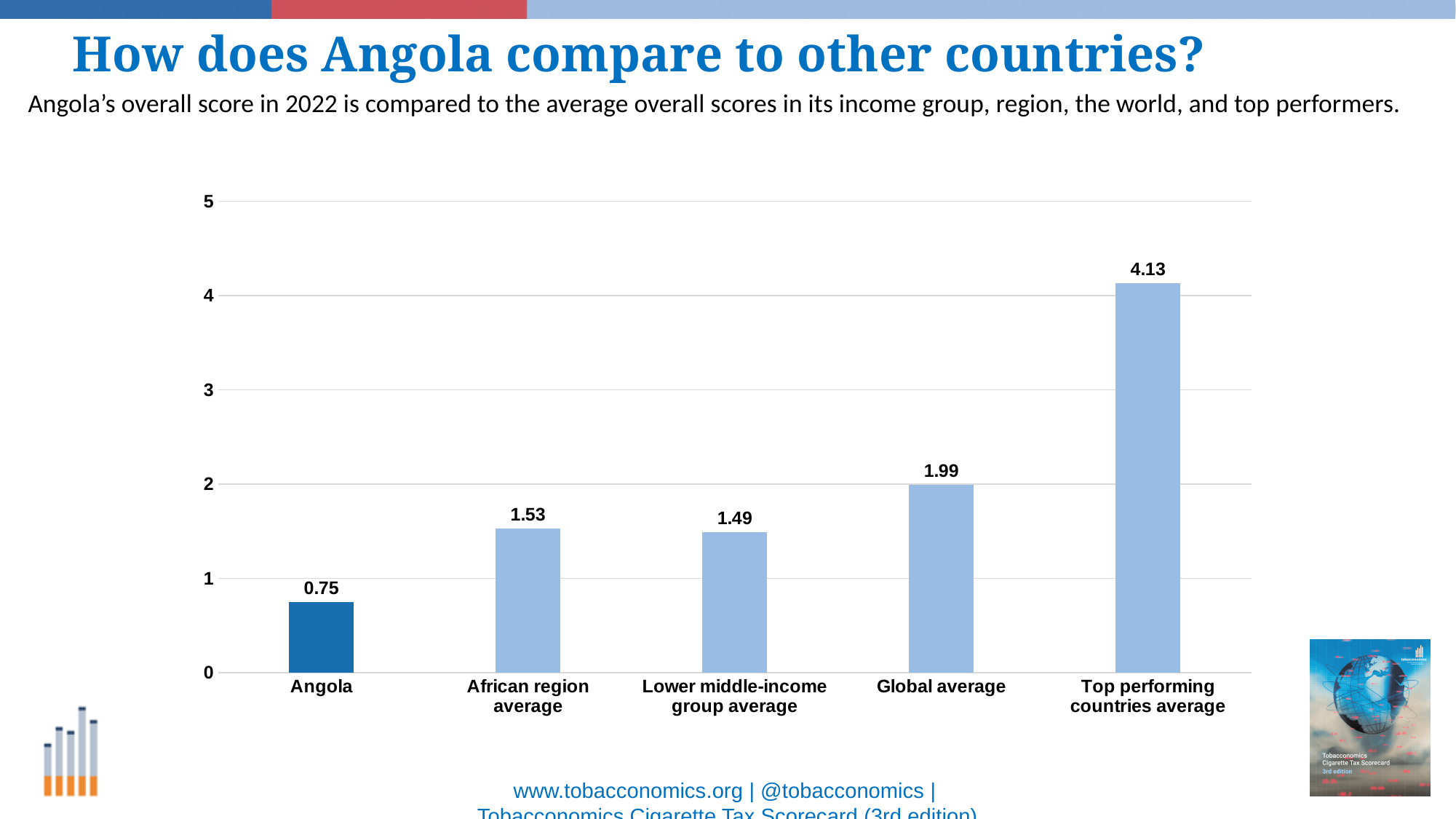
What is the value for the Global average? 1.99 How many categories are shown on the chart? 5 What is the value for the Lower middle-income group average? 1.49 What kind of chart is shown on the slide? Bar chart Which bar is shown in a darker blue than the others? Angola Which is larger, the Global average or the Lower middle-income group average? Global average What is the value for the Top performing countries average? 4.13 What is the difference between the Global average and the African region average? 0.46 Which category has the highest value? Top performing countries average Which category has the lowest value? Angola What is the value for Angola? 0.75 What is the difference between the Top performing countries average and Angola? 3.38